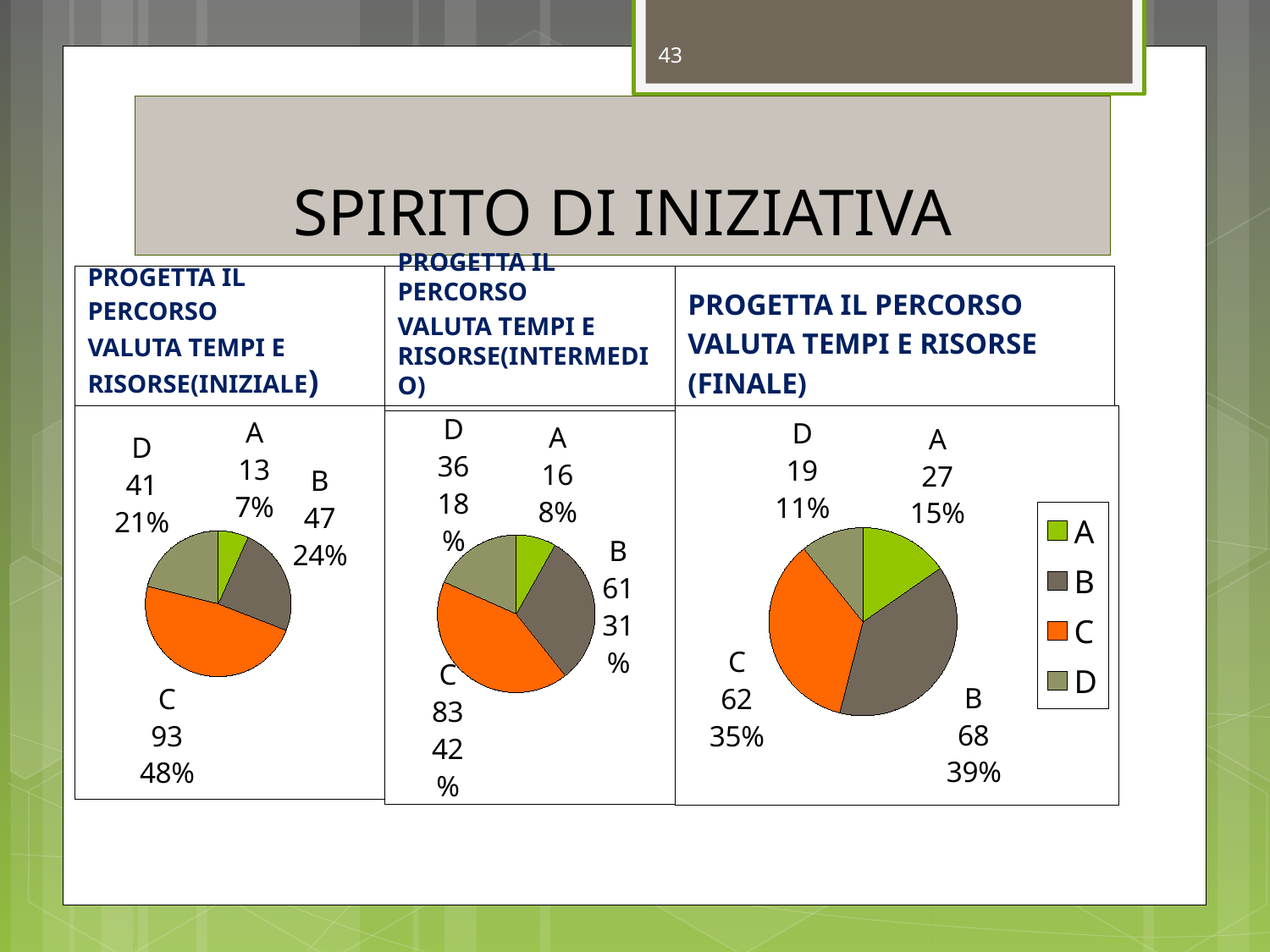
In the PROGETTA IL PERCORSO VALUTA TEMPI E RISORSE (INTERMEDIO) chart, which category has the largest slice? C How many categories does each pie chart on the slide show? 4 In the PROGETTA IL PERCORSO VALUTA TEMPI E RISORSE (FINALE) chart, what percentage share does C have? 35% What type of chart is used for the PROGETTA IL PERCORSO VALUTA TEMPI E RISORSE (FINALE) data? Pie chart In the PROGETTA IL PERCORSO VALUTA TEMPI E RISORSE (INTERMEDIO) chart, what is the value for B? 61 In the PROGETTA IL PERCORSO VALUTA TEMPI E RISORSE (FINALE) chart, is the value for B or the value for D larger? B In the PROGETTA IL PERCORSO VALUTA TEMPI E RISORSE (FINALE) chart, which category has the largest slice? B In the PROGETTA IL PERCORSO VALUTA TEMPI E RISORSE (FINALE) chart, what is the value for A? 27 In the PROGETTA IL PERCORSO VALUTA TEMPI E RISORSE (INTERMEDIO) chart, what is the difference between the values for C and D? 47 In the PROGETTA IL PERCORSO VALUTA TEMPI E RISORSE (INIZIALE) chart, what percentage share does D have? 21% In the PROGETTA IL PERCORSO VALUTA TEMPI E RISORSE (INIZIALE) chart, what is the value for C? 93 In the PROGETTA IL PERCORSO VALUTA TEMPI E RISORSE (INIZIALE) chart, which category has the smallest slice? A